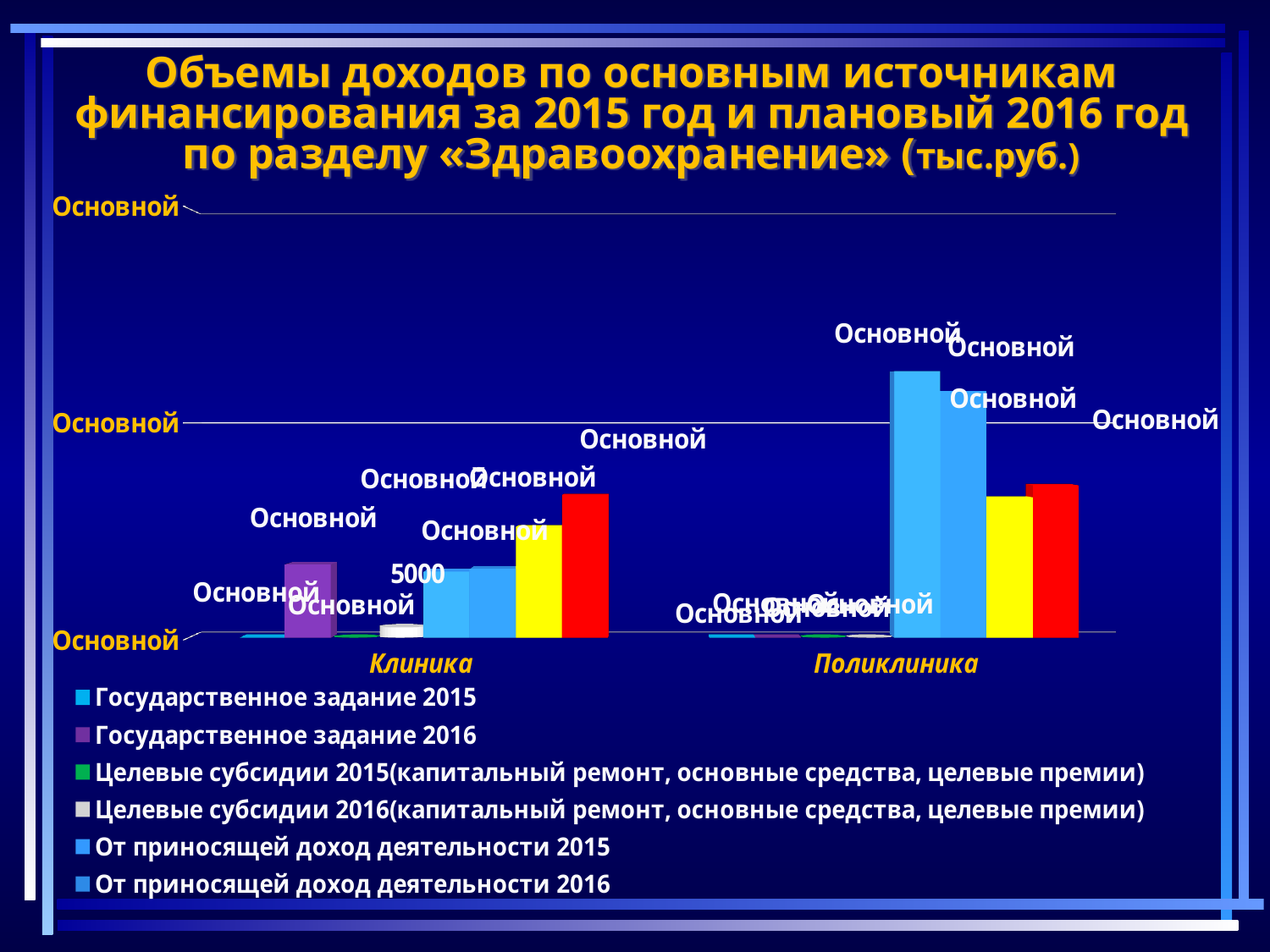
In the Поликлиника category, which bar is taller, the light blue bar or the yellow bar? the light blue bar Is the tallest bar in the Поликлиника category taller than the tallest bar in the Клиника category? yes In the Клиника category, which bar is taller, the red bar or the yellow bar? the red bar What kind of chart is shown on the slide? bar chart How many series does the chart legend list? 6 In which unit are the values in the chart expressed, according to the title? тыс.руб. What are the two categories on the x axis of the chart? Клиника and Поликлиника How many categories are shown on the x axis of the chart? 2